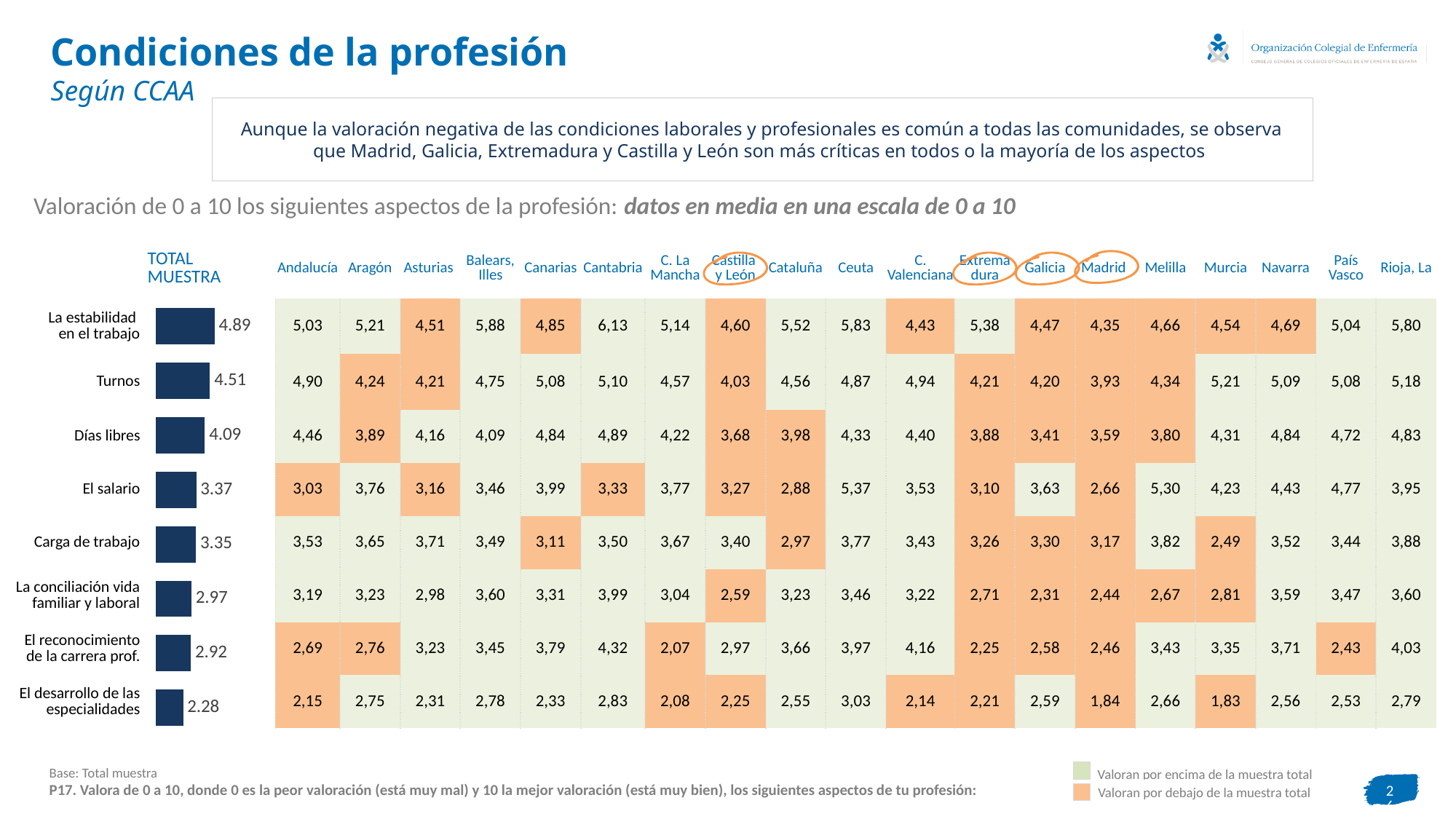
In the TOTAL MUESTRA bar chart, what is the difference between 'La estabilidad en el trabajo' and 'El desarrollo de las especialidades'? 2.61 In the TOTAL MUESTRA bar chart, which is larger: 'El salario' or 'Carga de trabajo'? El salario In the TOTAL MUESTRA bar chart, what is the value for 'El desarrollo de las especialidades'? 2.28 In the TOTAL MUESTRA bar chart, what is the value for 'La estabilidad en el trabajo'? 4.89 In the TOTAL MUESTRA bar chart, which category has the highest value? La estabilidad en el trabajo What kind of chart is the TOTAL MUESTRA chart? Bar chart In the TOTAL MUESTRA bar chart, which is larger: 'La conciliación vida familiar y laboral' or 'El reconocimiento de la carrera prof.'? La conciliación vida familiar y laboral How many categories does the TOTAL MUESTRA bar chart show? 8 In the TOTAL MUESTRA bar chart, what is the difference between 'Turnos' and 'Días libres'? 0.42 In the TOTAL MUESTRA bar chart, what is the value for 'El salario'? 3.37 Do the values in the TOTAL MUESTRA bar chart rise or fall from the top category to the bottom category? Fall In the TOTAL MUESTRA bar chart, which category has the lowest value? El desarrollo de las especialidades